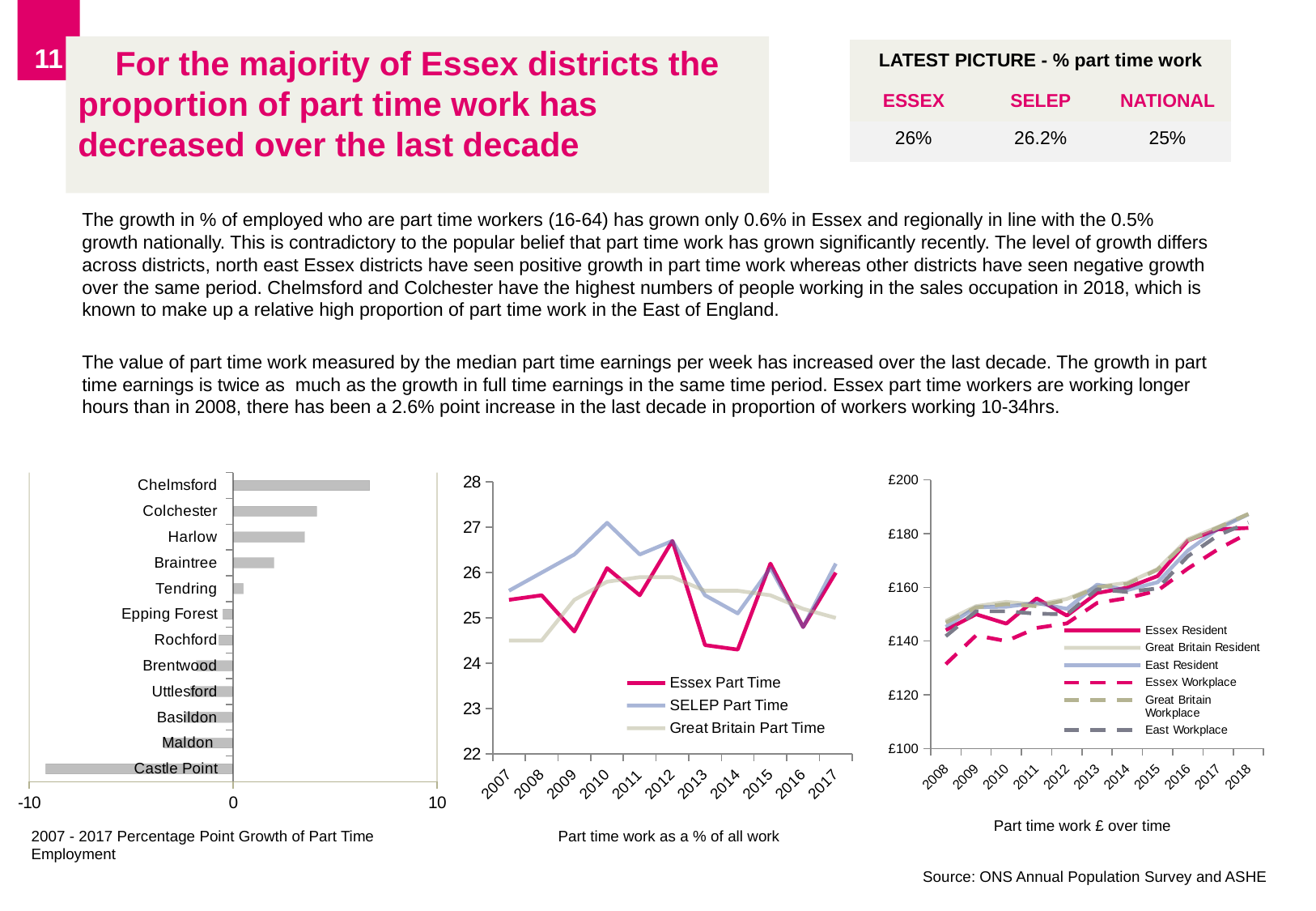
In the chart titled 'Part time work £ over time', how many series does the legend list? 6 In the chart titled '2007 - 2017 Percentage Point Growth of Part Time Employment', how many districts are shown? 12 In the chart titled '2007 - 2017 Percentage Point Growth of Part Time Employment', is the value for Castle Point greater or less than 0? less In the chart titled '2007 - 2017 Percentage Point Growth of Part Time Employment', which district has the highest value? Chelmsford What kind of chart is the one titled '2007 - 2017 Percentage Point Growth of Part Time Employment'? bar chart In the chart titled 'Part time work £ over time', do the values for Essex Resident generally rise or fall from 2008 to 2018? rise In the chart titled 'Part time work as a % of all work', is the value for Essex Part Time in 2014 greater or less than 25? less In the chart titled '2007 - 2017 Percentage Point Growth of Part Time Employment', which district has the lowest value? Castle Point In the chart titled 'Part time work £ over time', is the value for Essex Workplace in 2008 greater or less than £140? less In the chart titled 'Part time work as a % of all work', how many series does the legend list? 3 In the chart titled '2007 - 2017 Percentage Point Growth of Part Time Employment', which is larger, the value for Colchester or the value for Braintree? Colchester